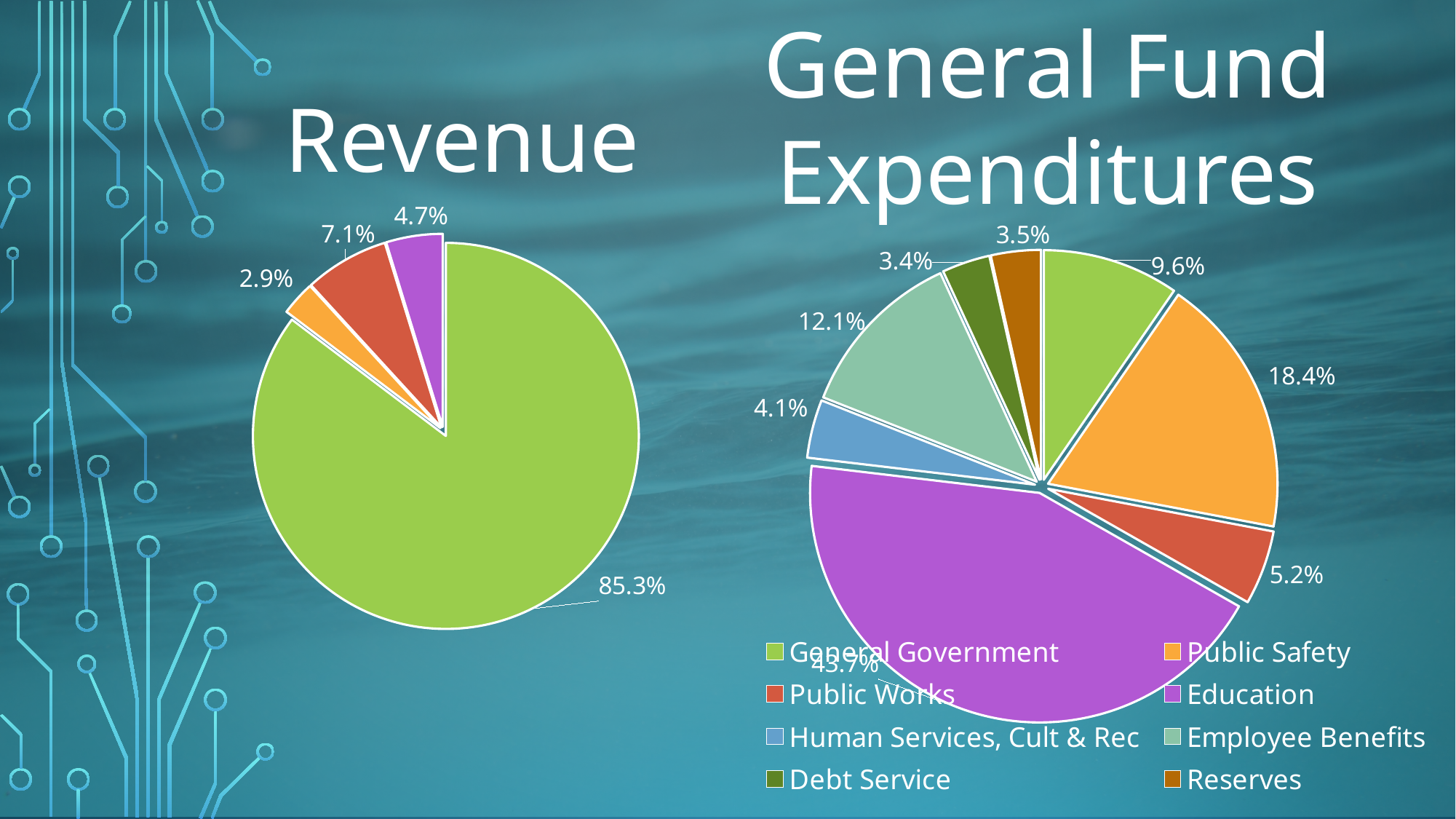
In the General Fund Expenditures chart, what share does Employee Benefits have? 12.1% In the General Fund Expenditures chart, what share does Education have? 43.7% In the General Fund Expenditures chart, what share does Public Safety have? 18.4% What kind of chart is the Revenue chart? pie chart How many slices does the Revenue pie chart have? 4 In the Revenue chart, what is the value of the smallest slice? 2.9% How many categories does the legend of the General Fund Expenditures chart list? 8 In the General Fund Expenditures chart, which category has the smallest share? Debt Service In the General Fund Expenditures chart, what is the difference between the Public Safety and General Government shares? 8.8% In the General Fund Expenditures chart, which is larger: Public Works or Human Services, Cult & Rec? Public Works In the Revenue chart, what is the value of the largest slice? 85.3% In the General Fund Expenditures chart, which category has the largest share? Education